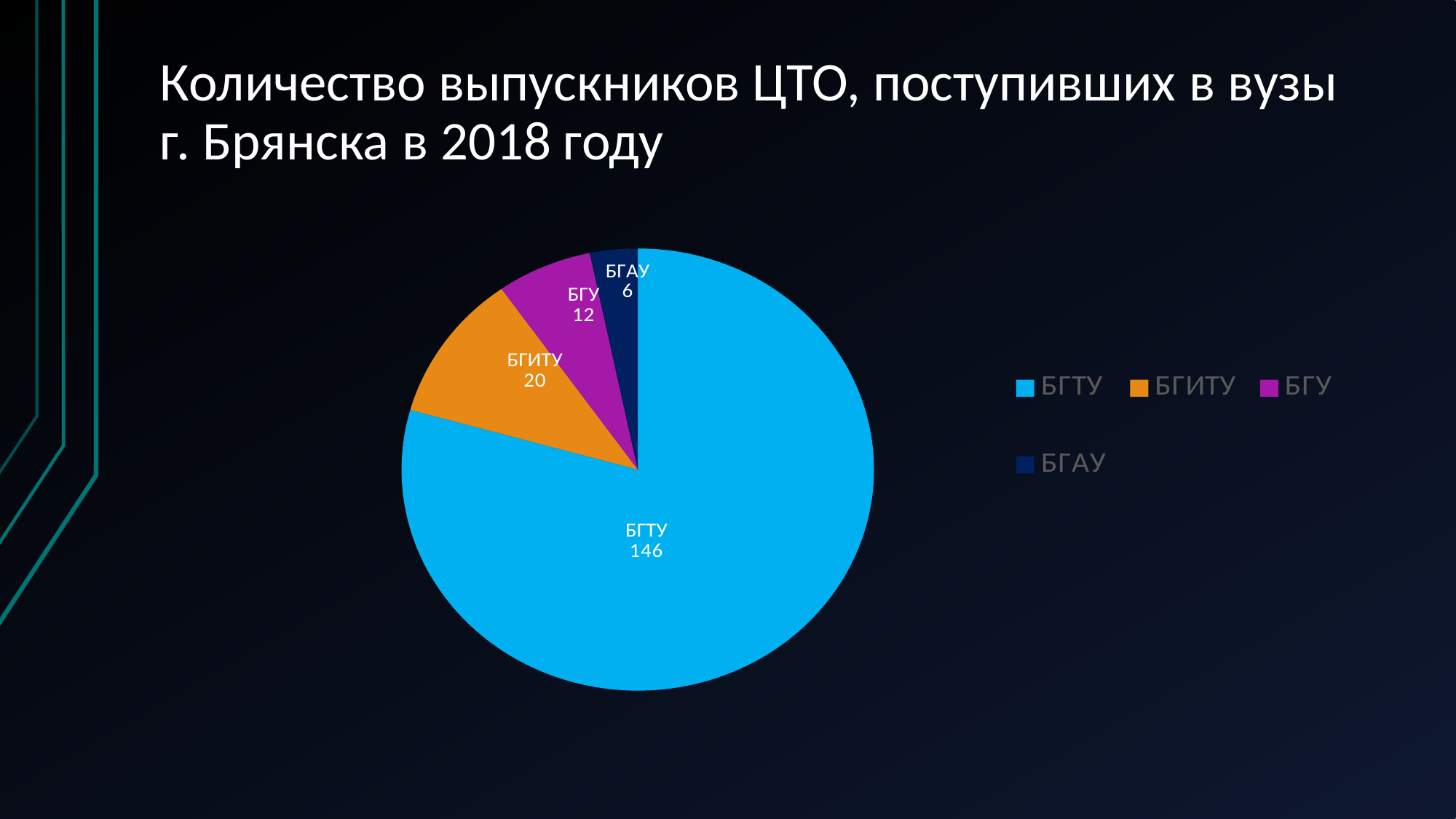
Which is larger, the value for БГУ or the value for БГАУ? БГУ What type of chart is shown on the slide? pie chart What is the total of all values shown in the pie chart? 184 How many categories (universities) are shown in the pie chart? 4 How many graduates entered БГТУ according to the chart? 146 What is the value shown for БГИТУ? 20 What is the value shown for БГУ? 12 Which university has the largest slice of the pie? БГТУ What is the title of the chart on the slide? Количество выпускников ЦТО, поступивших в вузы г. Брянска в 2018 году What is the value shown for БГАУ? 6 Which university has the smallest slice of the pie? БГАУ What is the difference between the values for БГТУ and БГИТУ? 126